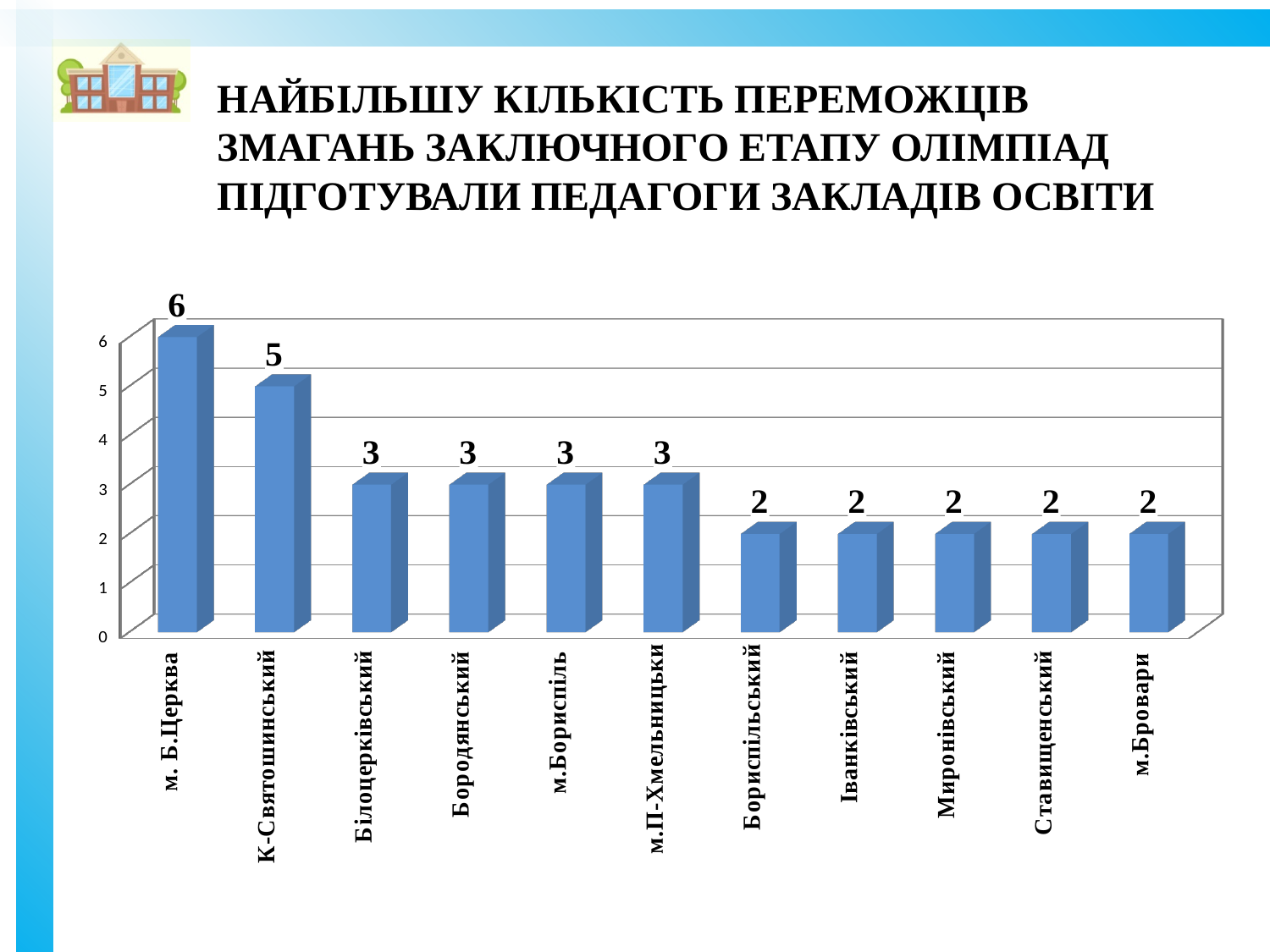
What value is shown for м.Бровари? 2 Which category has the highest value? м. Б.Церква What is the difference between the values for м. Б.Церква and К-Святошинський? 1 Do the values rise or fall from left to right along the x axis? fall Which is larger, the value for Білоцерківський or the value for Миронівський? Білоцерківський How many categories have a value of 2? 5 What value is shown for К-Святошинський? 5 What value is shown for Бородянський? 3 How many categories are shown on the chart? 11 What kind of chart is shown on the slide? bar chart What value is shown for м. Б.Церква? 6 What is the difference between the values for К-Святошинський and Іванківський? 3